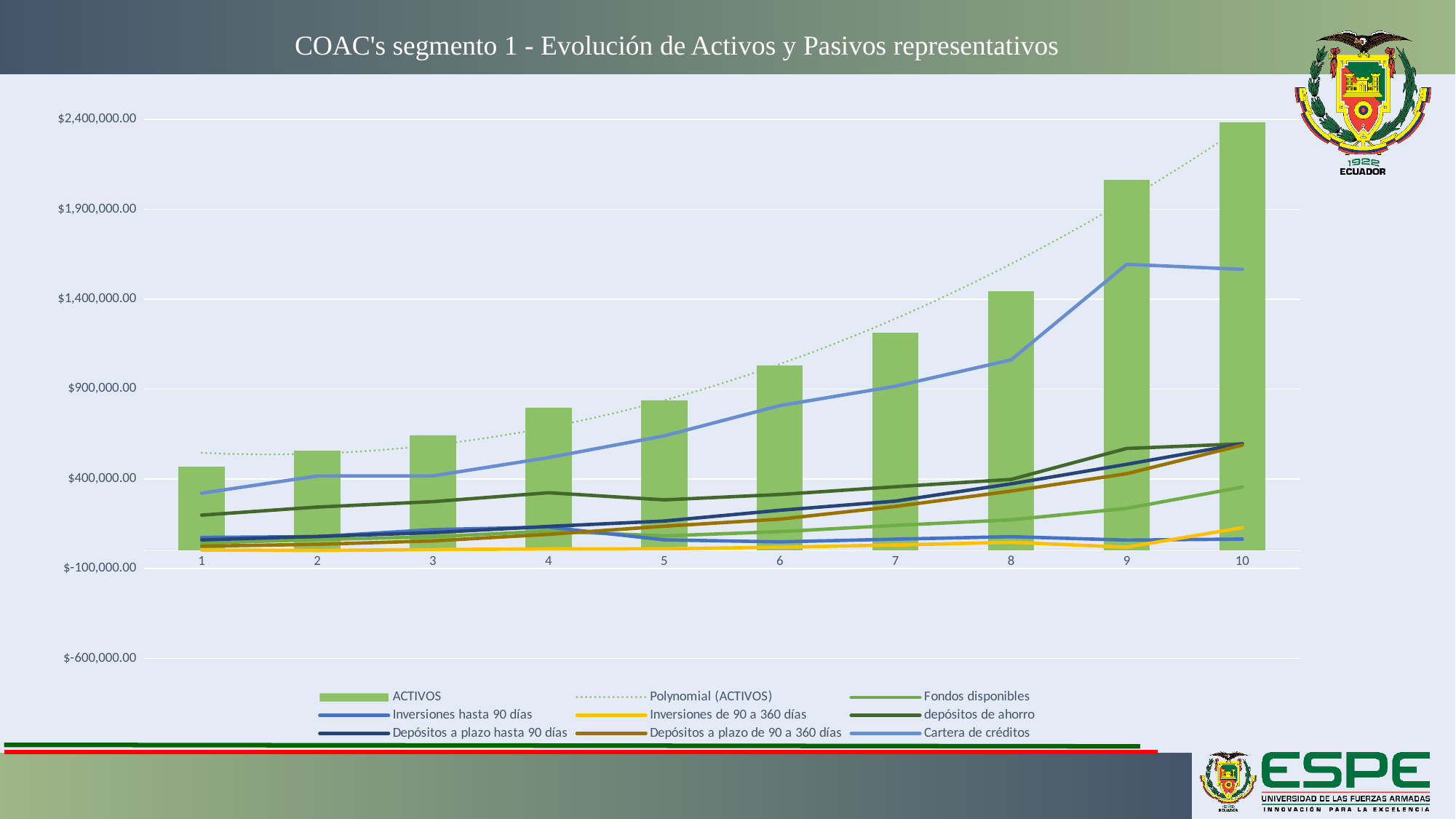
What kind of chart is this? Combined bar and line chart In which period is the ACTIVOS bar highest? 10 In which period is the ACTIVOS bar lowest? 1 Is the ACTIVOS value in period 1 greater or less than $900,000.00? less Is the ACTIVOS value in period 10 greater or less than $1,900,000.00? greater Which line series is the highest in period 10? Cartera de créditos What is the title of the chart? COAC's segmento 1 - Evolución de Activos y Pasivos representativos Which is larger in period 10: the ACTIVOS bar or the Cartera de créditos line? ACTIVOS Is the Cartera de créditos value in period 9 greater or less than $1,400,000.00? greater Do the ACTIVOS bars rise or fall from period 1 to period 10? Rise How many periods are shown on the x axis? 10 How many series does the legend list? 9